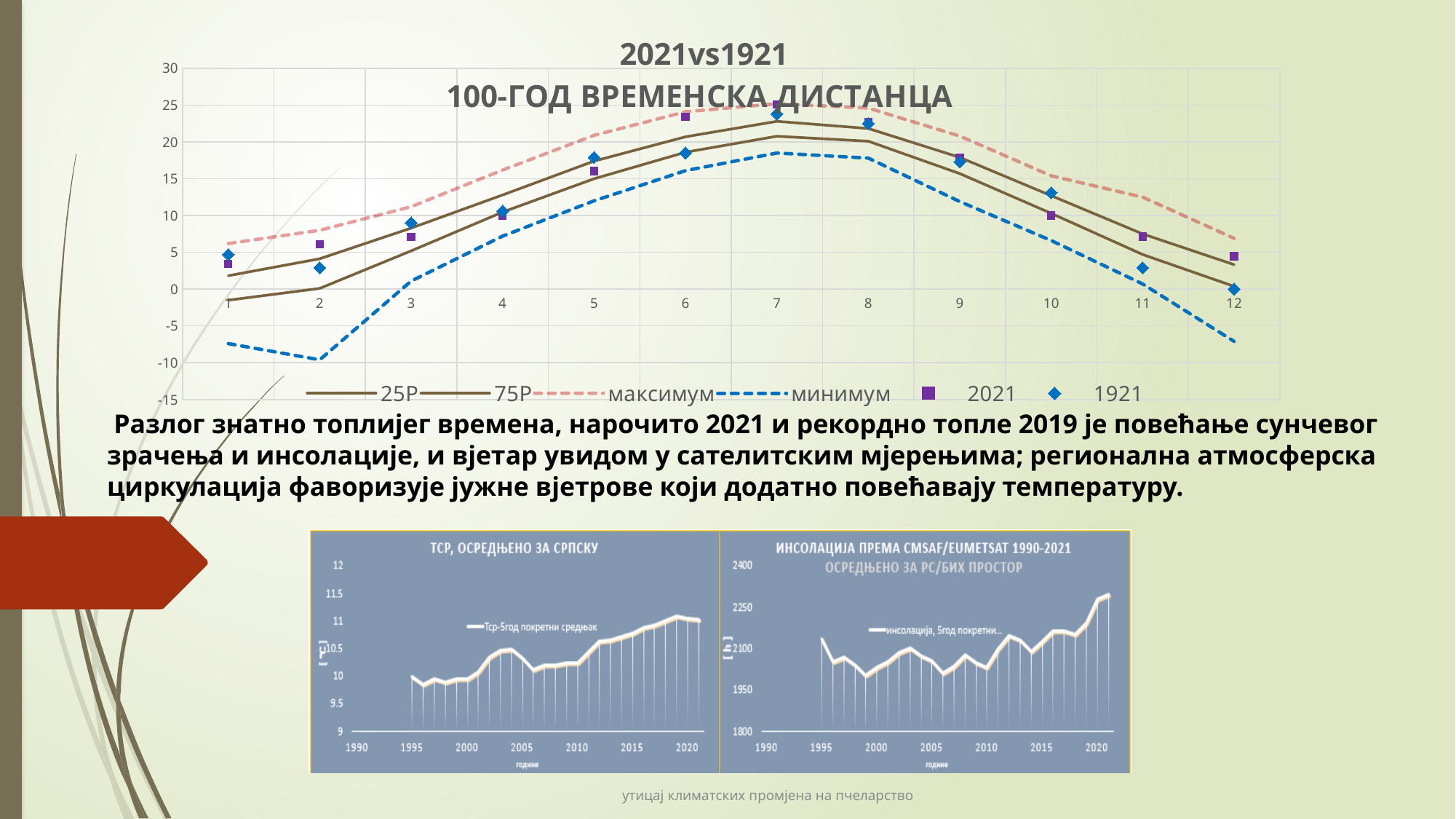
What kind of chart is the top chart titled '2021vs1921 100-ГОД ВРЕМЕНСКА ДИСТАНЦА'? line chart In the top chart '2021vs1921', which month has the highest 2021 value? 7 In the top chart '2021vs1921', how many series does the legend list? 6 In the top chart '2021vs1921', is the максимум value for month 7 greater or less than 20? greater In the top chart '2021vs1921', for month 2, which is larger: the 2021 value or the 1921 value? 2021 In the top chart '2021vs1921', is the 2021 value for month 6 greater or less than 20? greater In the top chart '2021vs1921', how many categories (months) are shown on the x axis? 12 In the top chart '2021vs1921', is the 2021 value for month 12 greater or less than 10? less In the top chart '2021vs1921', which month has the lowest 1921 value? 12 What is the title of the bottom-left chart on the slide? ТСР, ОСРЕДЊЕНО ЗА СРПСКУ In the top chart '2021vs1921', does the минимум line rise or fall from month 2 to month 7? rise